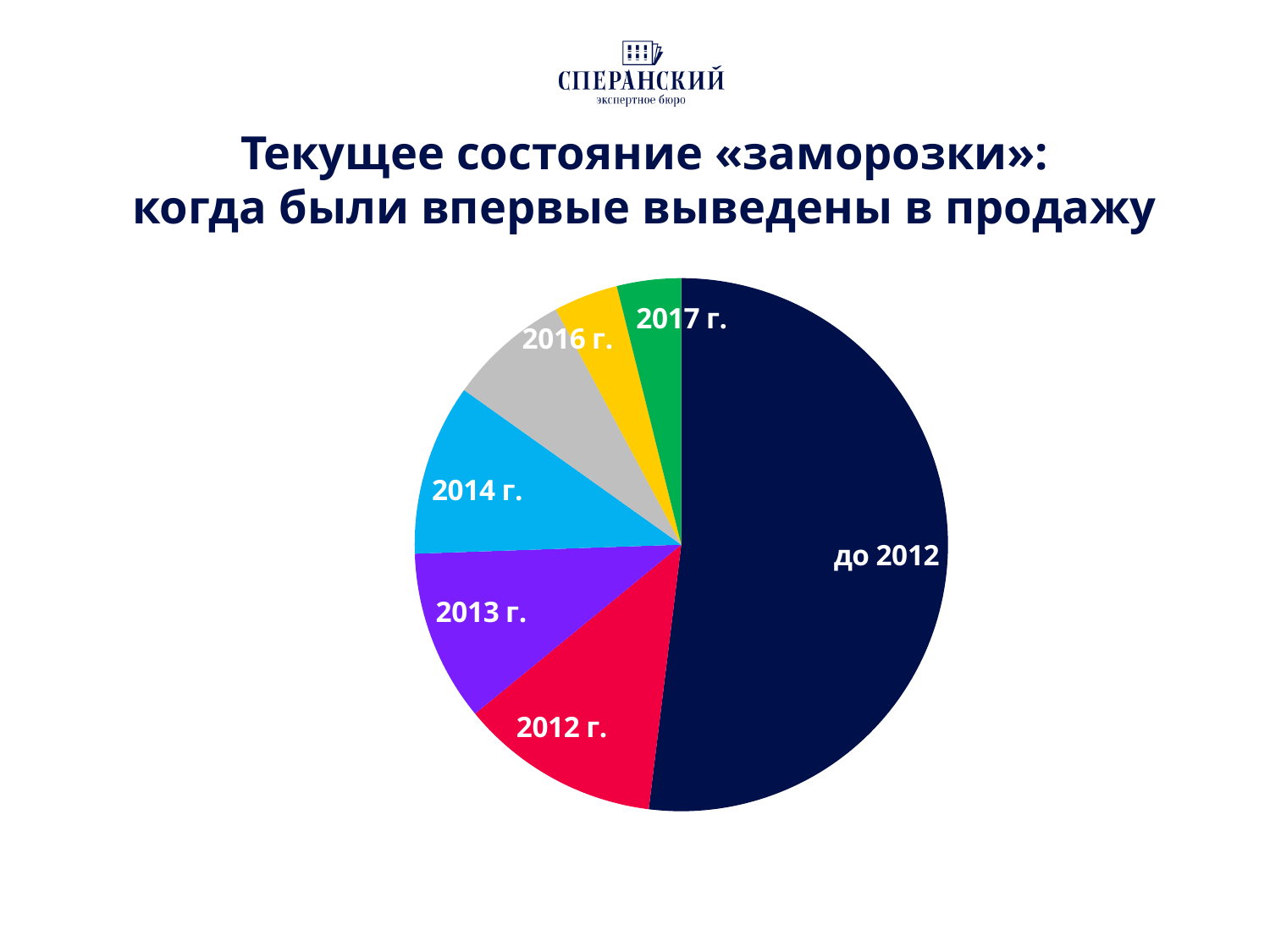
Which slice of the pie chart is the largest? до 2012 Which slice is larger, "2013 г." or "2017 г."? 2013 г. What colour is the "2012 г." slice of the pie chart? red What kind of chart is shown on the slide? pie chart Which slice is larger, "до 2012" or "2012 г."? до 2012 Which slice is larger, "2014 г." or "2017 г."? 2014 г. What is the title of the slide with the pie chart? Текущее состояние «заморозки»: когда были впервые выведены в продажу How many slices does the pie chart have? 7